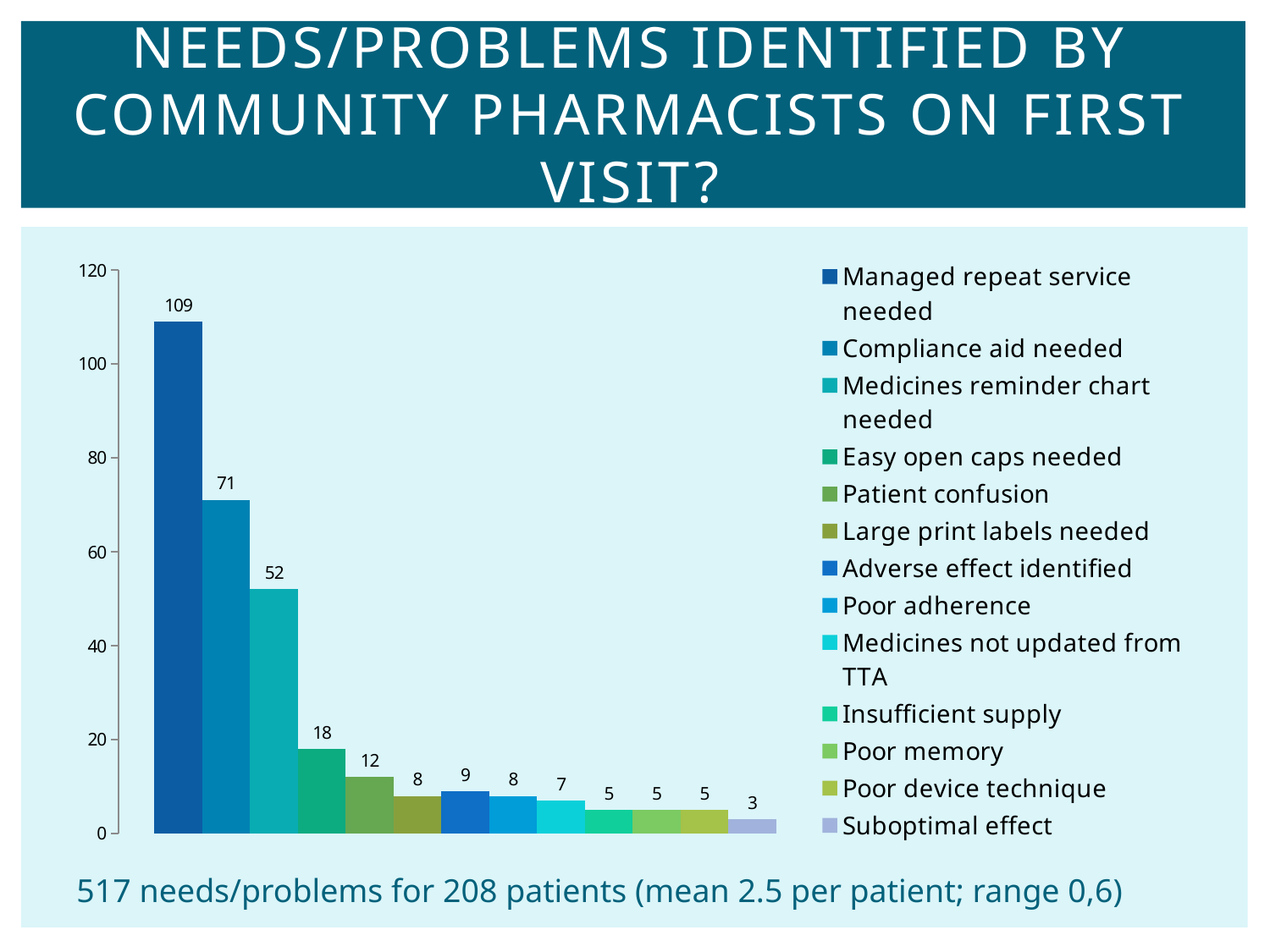
Which category has the lowest value? Suboptimal effect What value is shown for Compliance aid needed? 71 What value is shown for Managed repeat service needed? 109 How many entries does the legend list? 13 What value is shown for Easy open caps needed? 18 Which is larger, the value for Medicines reminder chart needed or the value for Easy open caps needed? Medicines reminder chart needed What is the difference between the values for Managed repeat service needed and Compliance aid needed? 38 Do the bar values rise or fall from left to right across the chart? fall Which category has the highest value? Managed repeat service needed What kind of chart is shown on the slide? bar chart Is the value for Medicines reminder chart needed greater or less than 60? less How many bars are plotted in the chart? 13